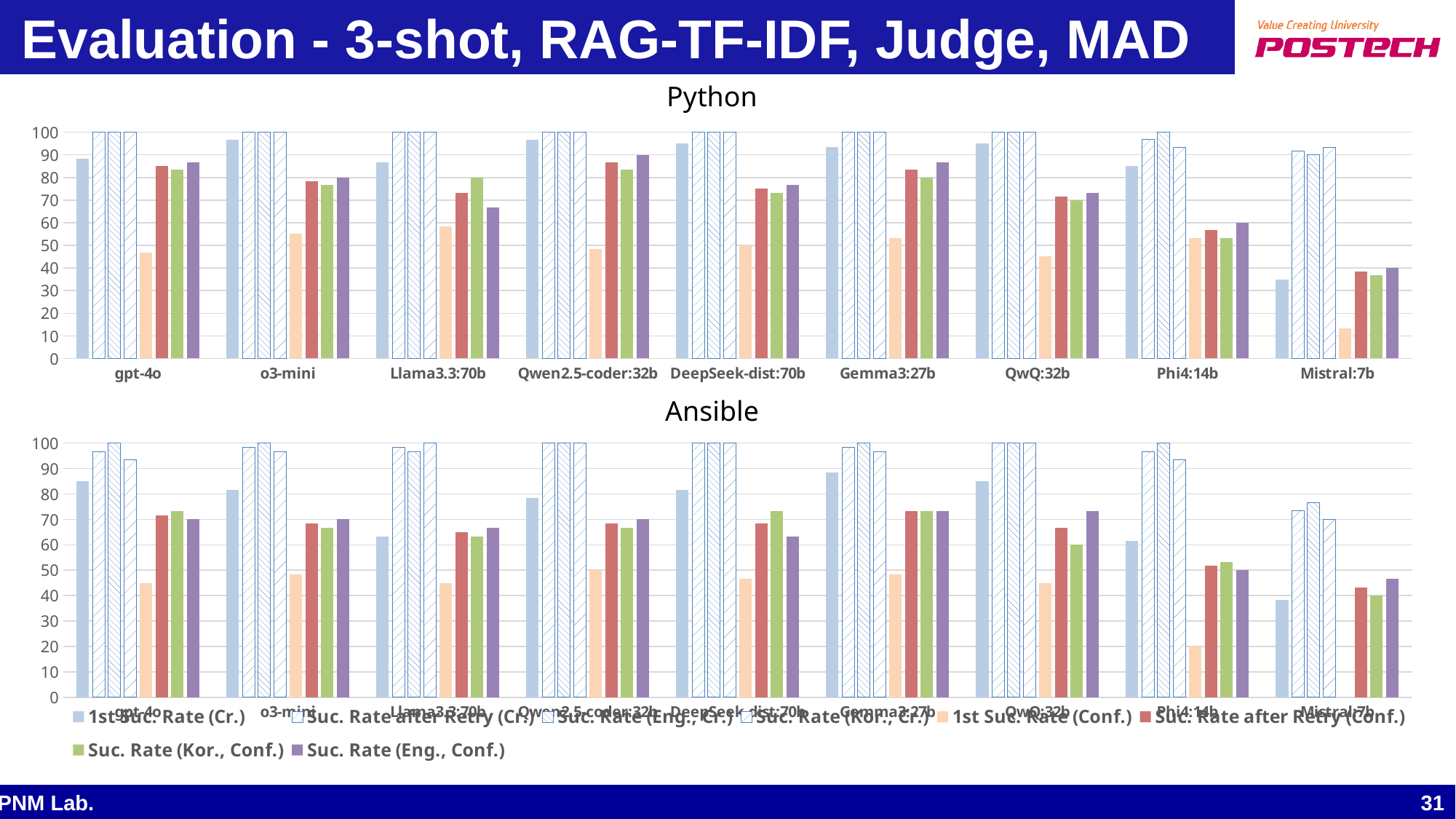
In the Ansible chart, what is the Suc. Rate (Eng., Cr.) value for gpt-4o? 100 In the Python chart, what is the Suc. Rate after Retry (Cr.) value for gpt-4o? 100 How many series does the legend list for the charts? 8 In the Python chart, what is the Suc. Rate (Eng., Cr.) value for Phi4:14b? 100 What is the title of the top chart on the slide? Python In the Python chart, is the 1st Suc. Rate (Conf.) value for Mistral:7b greater or less than 20? less In the Ansible chart, is the 1st Suc. Rate (Cr.) value for Mistral:7b greater or less than 50? less In the Python chart, is the 1st Suc. Rate (Cr.) value for Mistral:7b greater or less than 40? less In the Python chart, which model has the lowest 1st Suc. Rate (Cr.)? Mistral:7b How many model categories are shown on the x axis of the Ansible chart? 9 What kind of chart is the Python chart? bar chart In the Python chart, which is larger for 1st Suc. Rate (Cr.): gpt-4o or Mistral:7b? gpt-4o